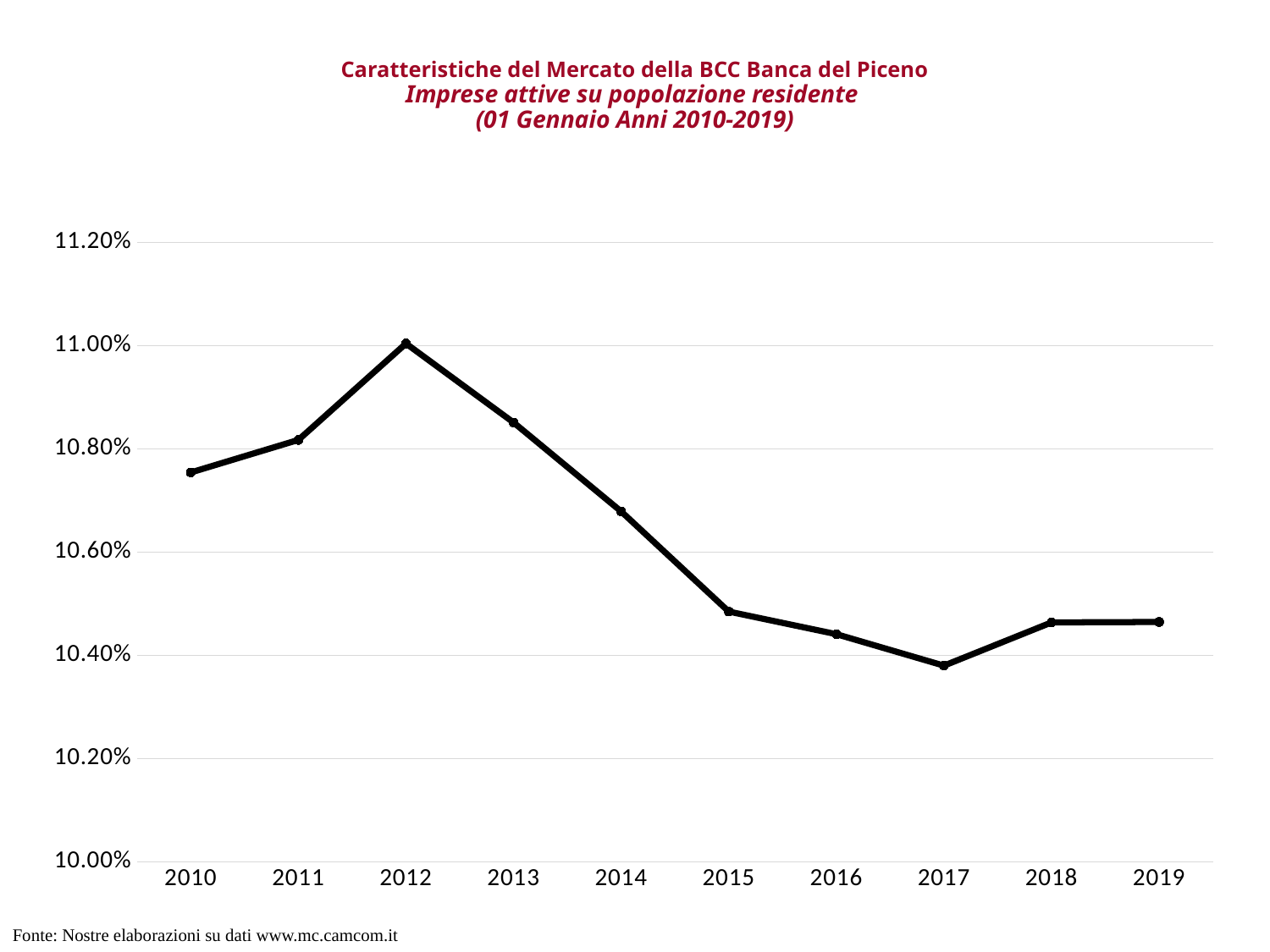
Which year has the larger value, 2011 or 2014? 2011 In which year is the share of active enterprises over resident population highest? 2012 Is the value for 2017 greater or less than 10.40%? less Is the value for 2010 greater or less than 10.60%? greater Is the value for 2015 greater or less than 10.60%? less What source is cited at the bottom of the slide? Nostre elaborazioni su dati www.mc.camcom.it Which year has the larger value, 2010 or 2013? 2013 In which year is the share of active enterprises over resident population lowest? 2017 How many years are plotted on the x axis? 10 What kind of chart is shown on the slide? line chart Do the values rise or fall from 2012 to 2017? fall